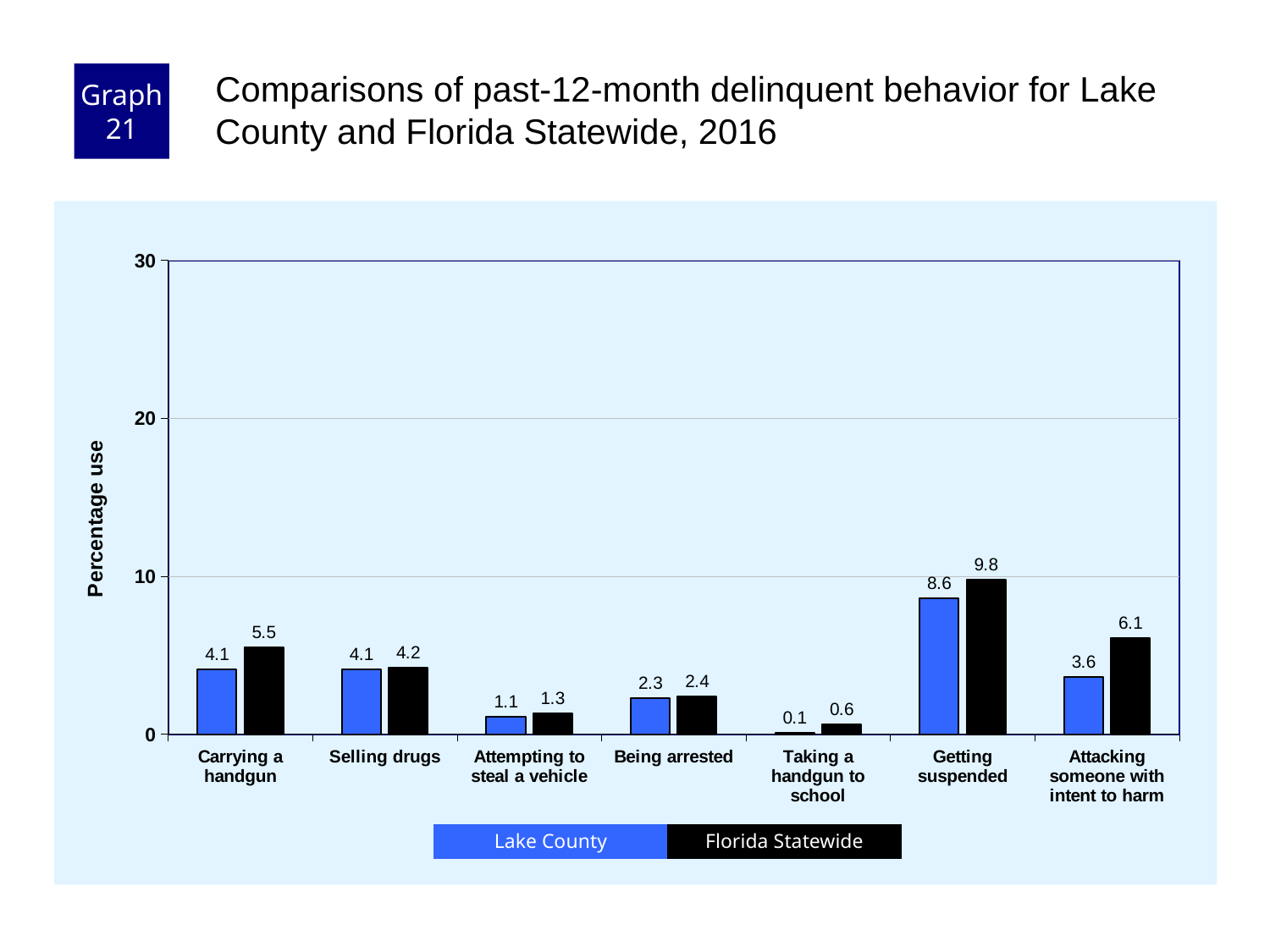
What is the Lake County value for Taking a handgun to school? 0.1 What is the difference between the Florida Statewide and Lake County values for Carrying a handgun? 1.4 What is the Florida Statewide value for Attacking someone with intent to harm? 6.1 What kind of chart is shown on the slide? bar chart What is the difference between the Florida Statewide and Lake County values for Attacking someone with intent to harm? 2.5 What is the Lake County value for Getting suspended? 8.6 Which category has the lowest Lake County value? Taking a handgun to school How many series does the legend list? 2 Is the Florida Statewide value for Getting suspended greater or less than 10? less Which category has the highest Florida Statewide value? Getting suspended How many categories are shown on the x axis? 7 Which is larger for Getting suspended: the Lake County value or the Florida Statewide value? Florida Statewide